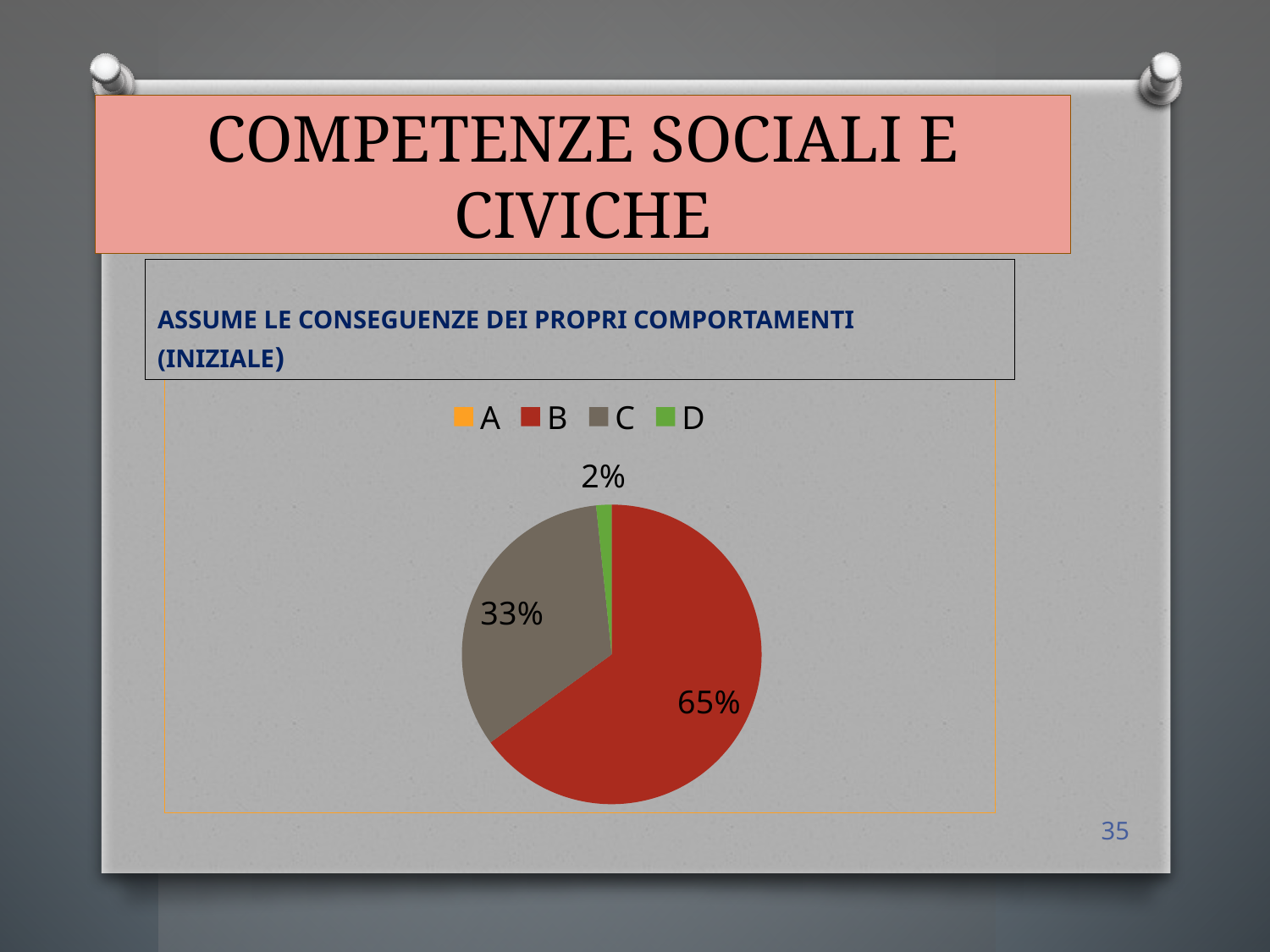
What kind of chart is shown on the slide? pie chart Which slice is larger, B or C? B What percentage does slice C represent in the pie chart? 33% What percentage does slice D represent in the pie chart? 2% How many slices in the pie chart have a percentage label? 3 What percentage does slice B represent in the pie chart? 65% Which category has the largest slice in the pie chart? B What is the title shown above the pie chart? ASSUME LE CONSEGUENZE DEI PROPRI COMPORTAMENTI (INIZIALE) What is the difference in percentage points between slice B and slice C? 32 What colour is used for category B in the pie chart? red How many entries does the legend of the pie chart list? 4 Which of the labelled slices in the pie chart is the smallest? D